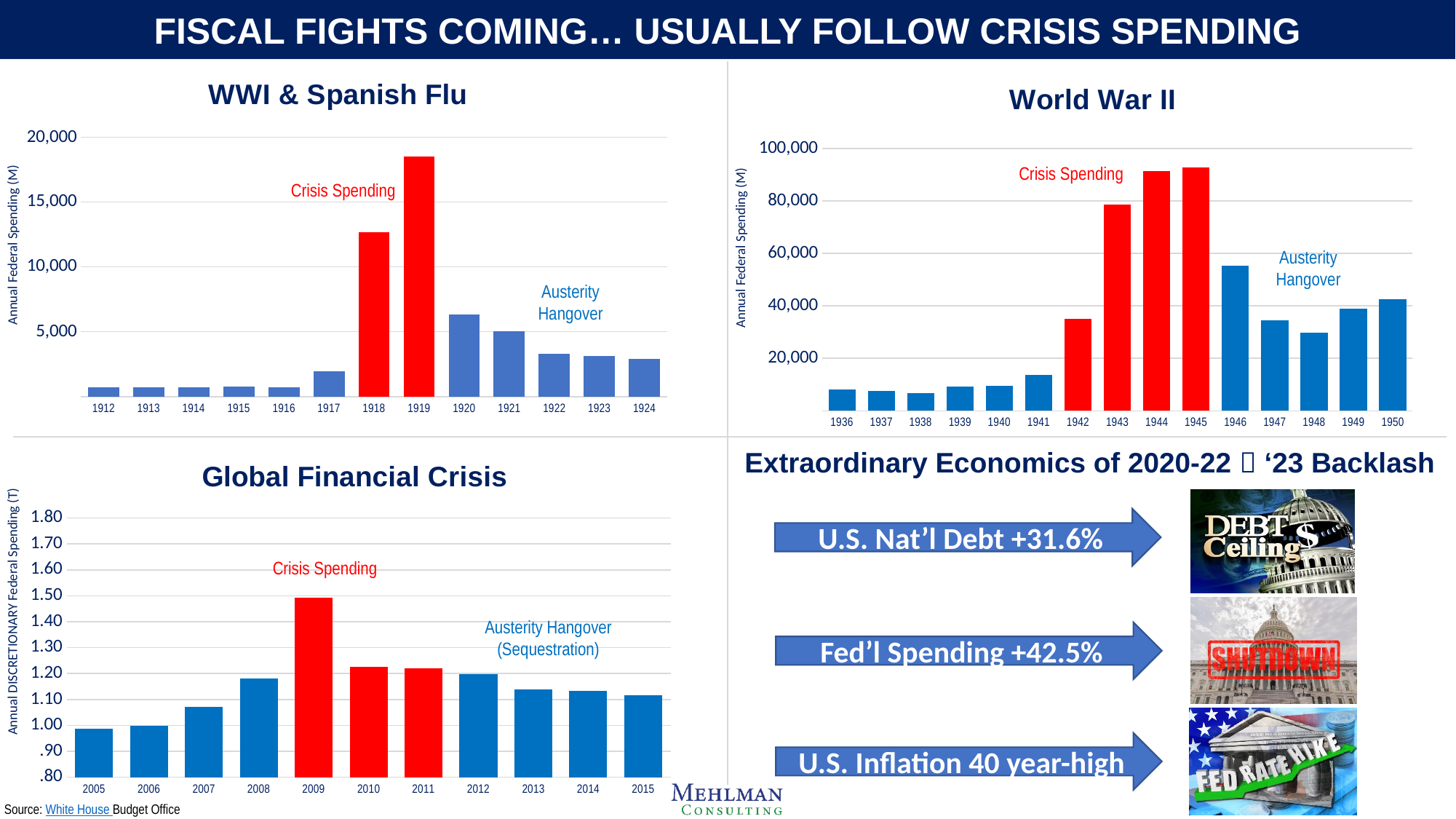
In the World War II chart, is the value for 1942 greater or less than 40,000? less In the World War II chart, is the value for 1946 greater or less than 40,000? greater How many years are plotted in the WWI & Spanish Flu chart? 13 In the Global Financial Crisis chart, which year has the highest value? 2009 In the Global Financial Crisis chart, do the values rise or fall from 2012 to 2015? fall In the Global Financial Crisis chart, is the value for 2009 greater or less than 1.40? greater In the World War II chart, which is larger, the value for 1946 or the value for 1947? 1946 In the WWI & Spanish Flu chart, which year has the highest annual federal spending? 1919 How many years are plotted in the World War II chart? 15 What kind of chart is the Global Financial Crisis chart? bar chart